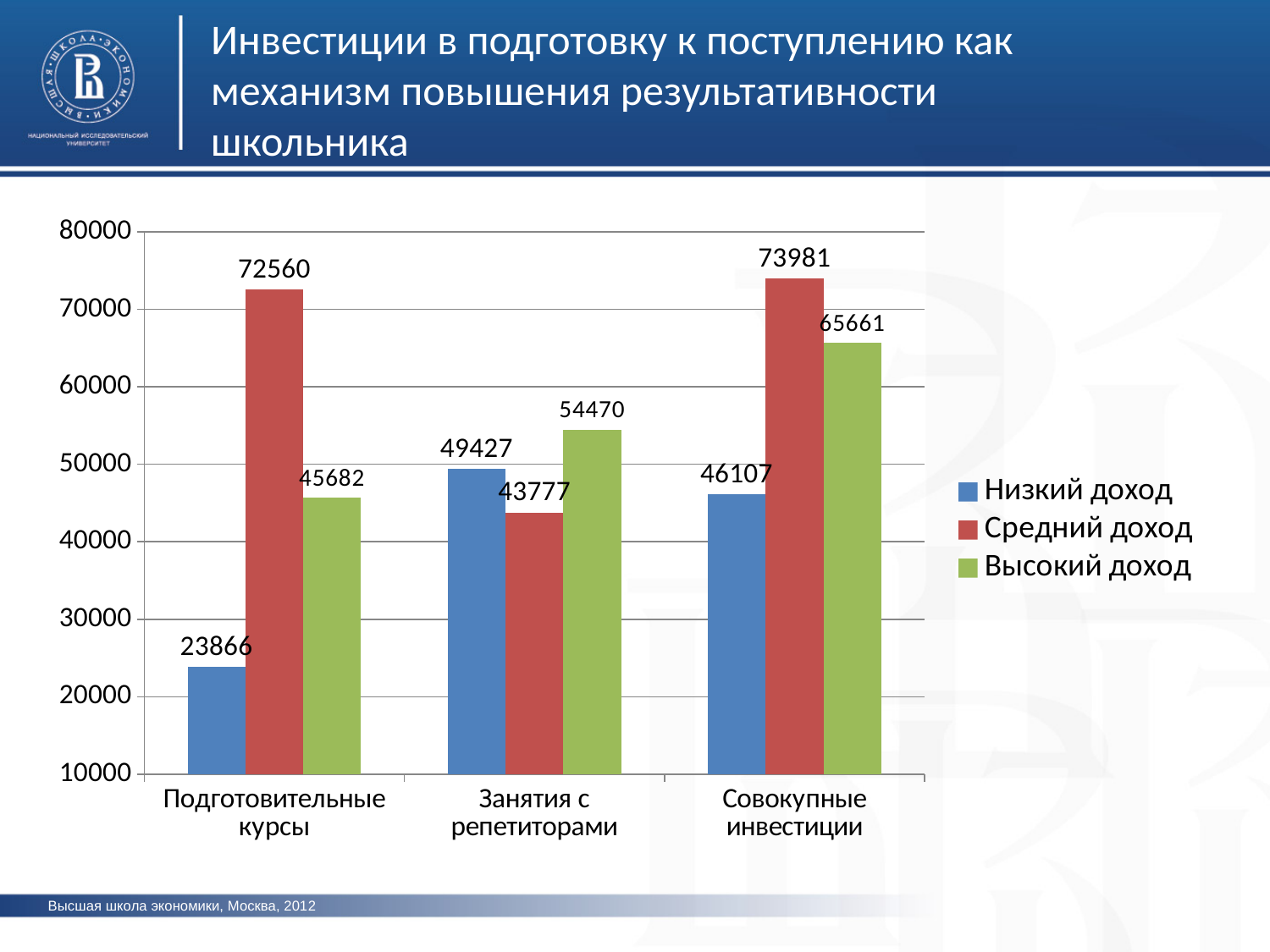
Which is larger: Низкий доход for Занятия с репетиторами or Низкий доход for Совокупные инвестиции? Занятия с репетиторами What is the value for Низкий доход in the Подготовительные курсы category? 23866 What is the value for Средний доход in the Совокупные инвестиции category? 73981 What kind of chart is shown on the slide? bar chart Is the value for Высокий доход in the Подготовительные курсы category greater or less than 50000? less What is the value for Высокий доход in the Занятия с репетиторами category? 54470 Which income group has the highest value in the Подготовительные курсы category? Средний доход What is the difference between Средний доход and Высокий доход in the Совокупные инвестиции category? 8320 What colour are the bars for Средний доход? red How many categories are shown on the x axis? 3 How many series does the legend list? 3 Which income group has the lowest value in the Занятия с репетиторами category? Средний доход